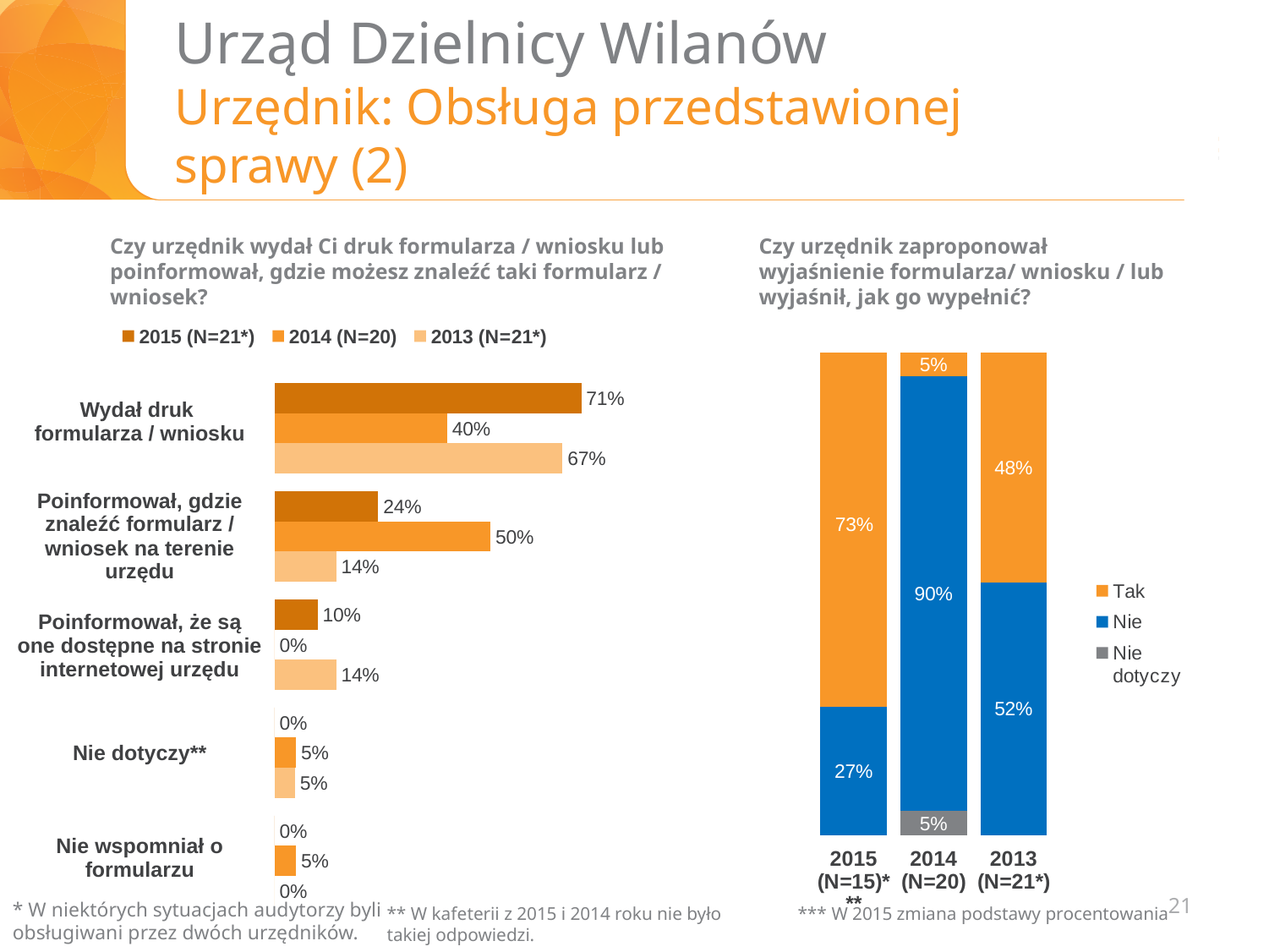
In the left chart, what is the difference between the 2015 and 2014 values for 'Wydał druk formularza / wniosku'? 31 percentage points How many series does the legend of the left chart list? 3 In the right chart, what is the 'Nie' share for 2014 (N=20)? 90% In the right chart, what is the 'Tak' share for 2015 (N=15)*? 73% In the left chart, which is larger for 'Poinformował, gdzie znaleźć formularz / wniosek na terenie urzędu': the 2015 value or the 2014 value? 2014 What type of chart is the chart on the right? Stacked bar chart In the right chart, which year has the highest 'Tak' share? 2015 (N=15)* How many categories are shown in the left chart? 5 In the left chart, what is the value for 'Poinformował, gdzie znaleźć formularz / wniosek na terenie urzędu' in the 2014 (N=20) series? 50% In the left chart, what is the value for 'Wydał druk formularza / wniosku' in the 2015 (N=21*) series? 71% In the left chart, what is the value for 'Poinformował, że są one dostępne na stronie internetowej urzędu' in the 2013 (N=21*) series? 14% In the left chart, which category has the highest value in the 2015 (N=21*) series? Wydał druk formularza / wniosku